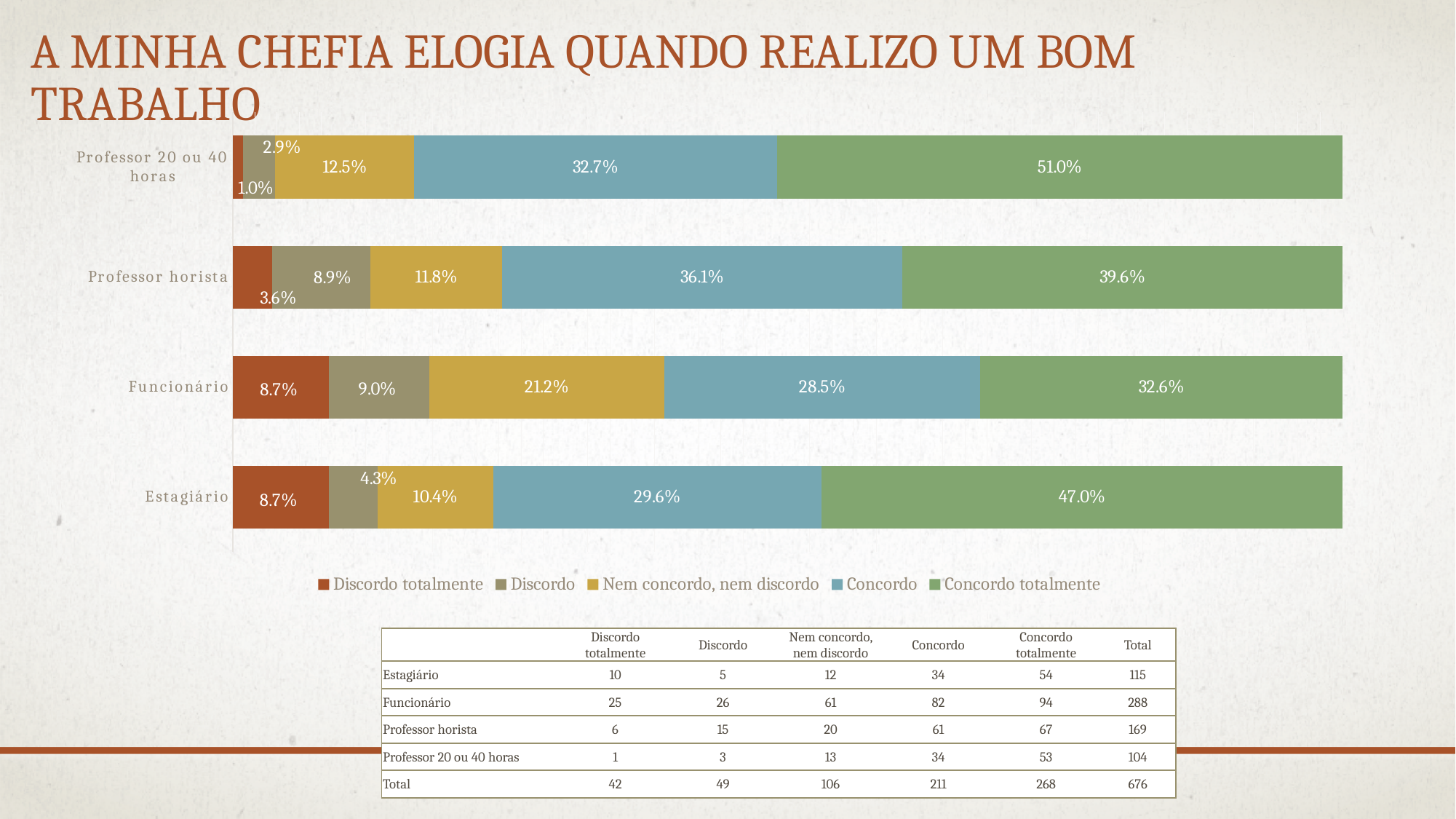
What is the value for "Concordo totalmente" for Professor 20 ou 40 horas? 51.0% What kind of chart is shown on the slide? Stacked bar chart What is the value for "Concordo" for Professor horista? 36.1% Which legend entry is shown in green? Concordo totalmente How many series does the legend list? 5 What is the difference between the "Concordo totalmente" values for Estagiário and Funcionário? 14.4% What is the value for "Nem concordo, nem discordo" for Funcionário? 21.2% Which category has the lowest value for "Discordo totalmente"? Professor 20 ou 40 horas How many categories are shown on the chart? 4 Which is larger: the "Concordo" value for Professor horista or for Estagiário? Professor horista Which category has the highest value for "Concordo totalmente"? Professor 20 ou 40 horas What is the value for "Discordo" for Estagiário? 4.3%